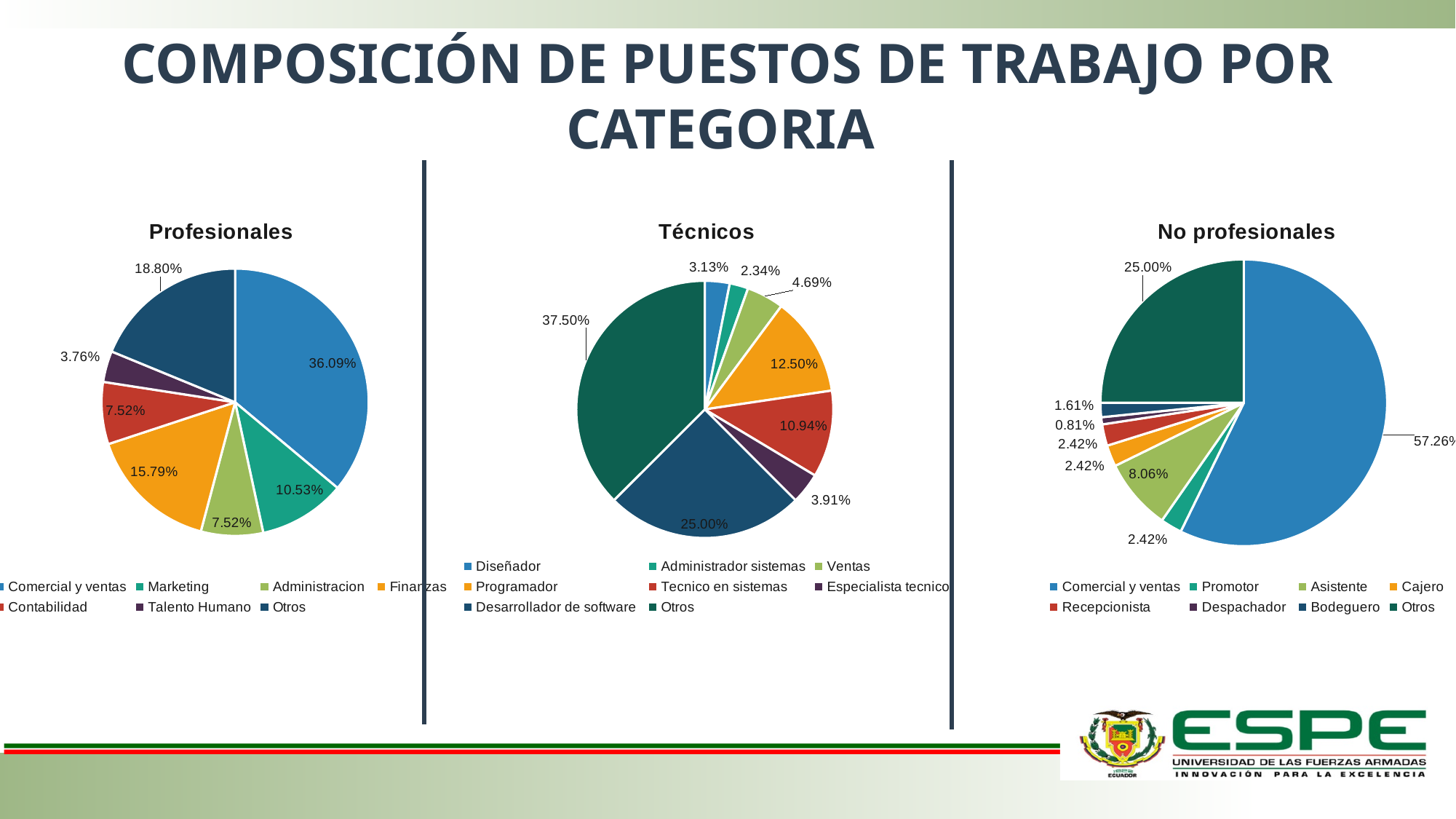
In the No profesionales chart, how many categories does the legend list? 8 In the Profesionales chart, how many categories does the legend list? 7 In the No profesionales chart, which category has the smallest share? Despachador In the Profesionales chart, which category has the smallest share? Talento Humano In the Técnicos chart, what is the difference between the shares of Programador and Tecnico en sistemas? 1.56% What type of chart is used for the three charts on the slide? Pie chart In the No profesionales chart, what share does Comercial y ventas have? 57.26% In the Técnicos chart, which is larger, Ventas or Diseñador? Ventas In the Profesionales chart, what share does Comercial y ventas have? 36.09% In the Técnicos chart, what share does Desarrollador de software have? 25.00% In the Profesionales chart, what share does Finanzas have? 15.79% In the Técnicos chart, which category has the largest share? Otros